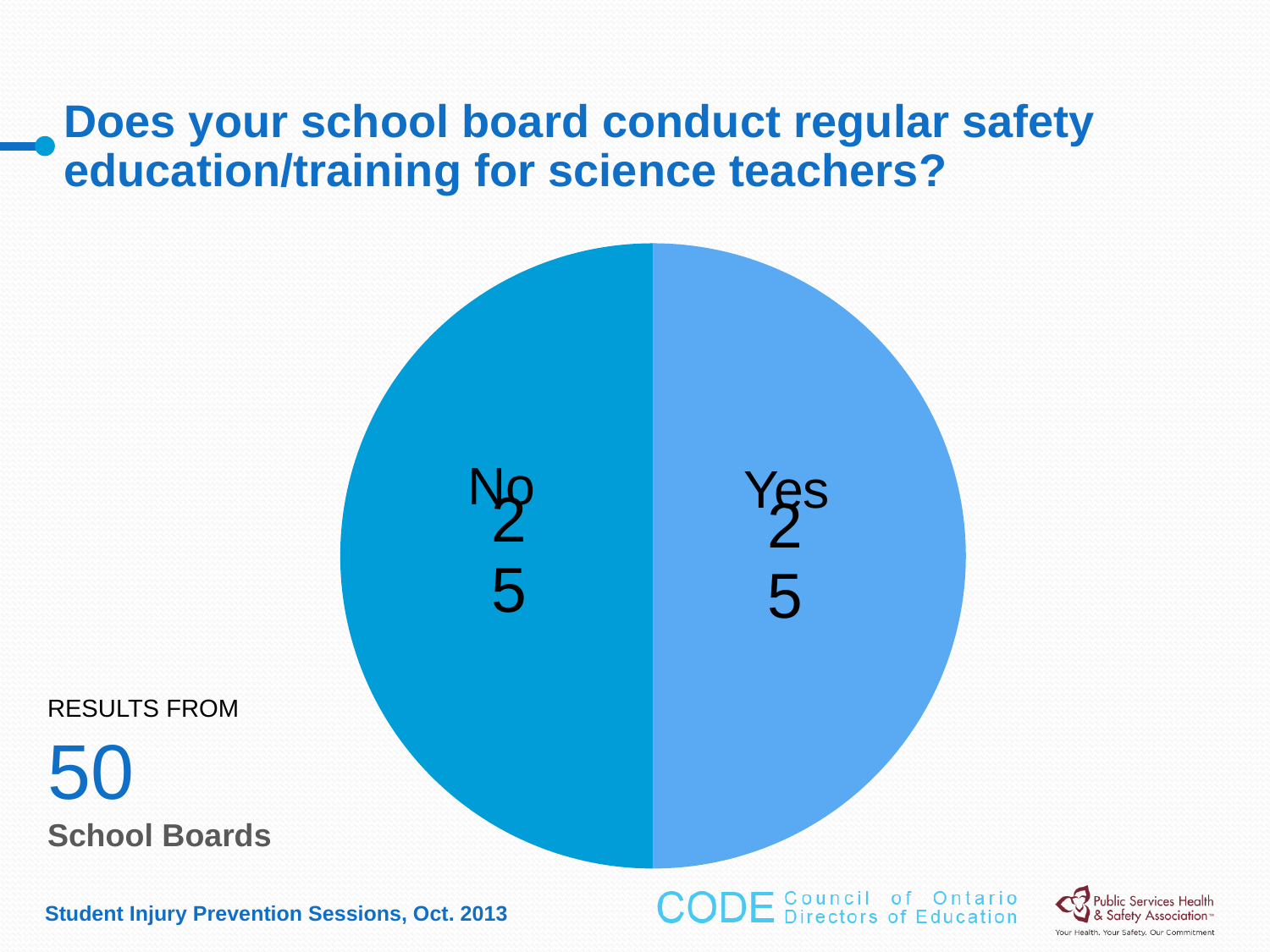
What is the value shown for the "Yes" slice? 25 What is the total of the two slices in the pie chart? 50 What share of the pie does the "Yes" slice represent? 50% What question does the chart title ask? Does your school board conduct regular safety education/training for science teachers? What kind of chart is shown on the slide? pie chart What is the value shown for the "No" slice? 25 How many school boards do the results come from? 50 What share of the pie does the "No" slice represent? 50% How many slices does the pie chart have? 2 What is the difference between the "Yes" and "No" values? 0 Which slice is on the left side of the pie chart? No